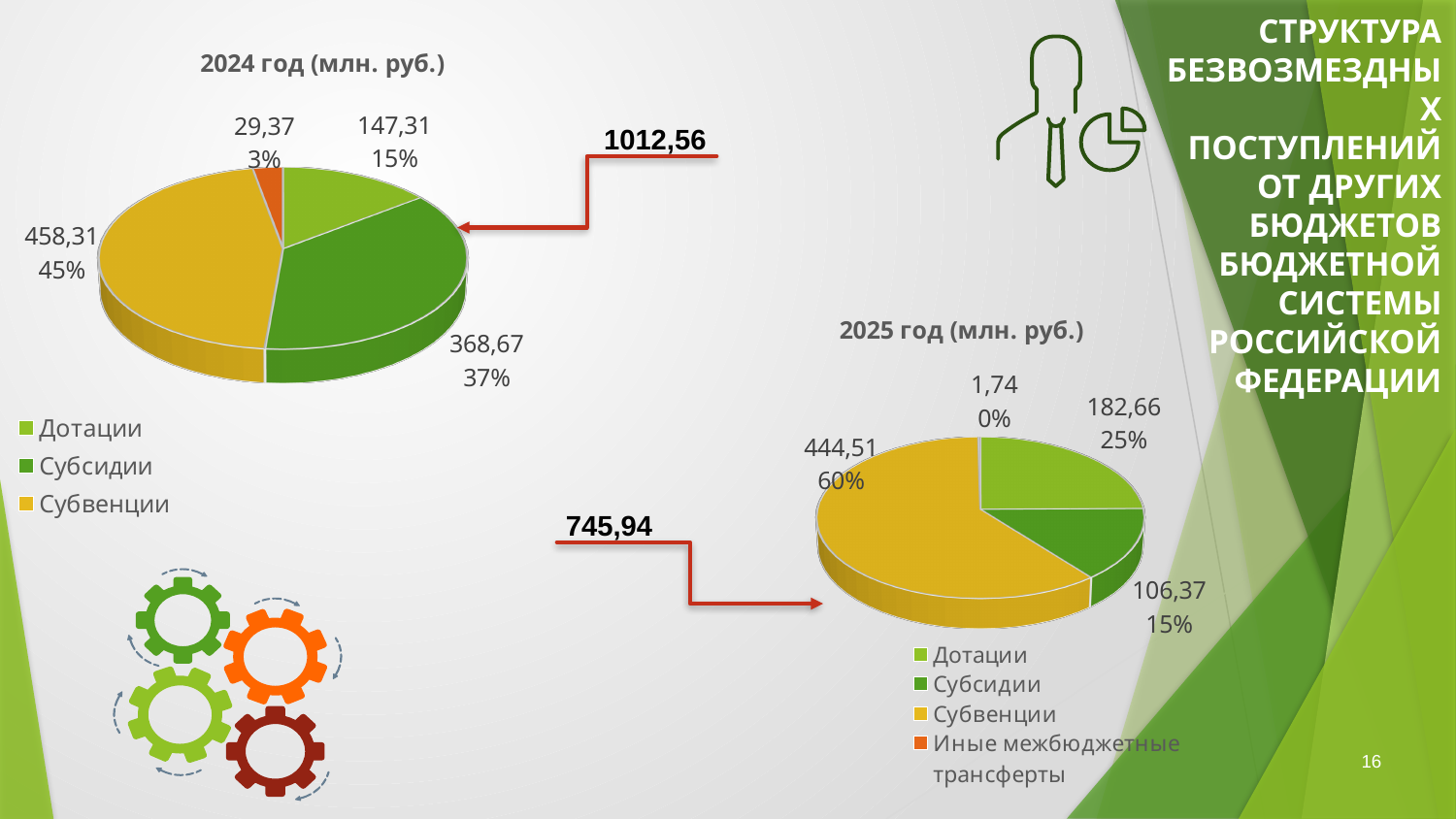
In the chart titled "2024 год (млн. руб.)", what share of the pie is Субсидии? 37% In the chart titled "2024 год (млн. руб.)", which category has the largest slice? Субвенции In the chart titled "2025 год (млн. руб.)", which is larger, Дотации or Субсидии? Дотации In the chart titled "2024 год (млн. руб.)", what is the value for Субвенции? 458,31 What kind of chart is the chart titled "2025 год (млн. руб.)"? Pie chart In the chart titled "2025 год (млн. руб.)", how many entries does the legend list? 4 In the chart titled "2025 год (млн. руб.)", what share of the pie is Дотации? 25% In the chart titled "2024 год (млн. руб.)", what is the difference between the values for Субвенции and Субсидии? 89,64 In the chart titled "2025 год (млн. руб.)", what is the difference between the values for Дотации and Субсидии? 76,29 In the chart titled "2024 год (млн. руб.)", what is the value for Дотации? 147,31 In the chart titled "2025 год (млн. руб.)", which category has the smallest slice? Иные межбюджетные трансферты In the chart titled "2025 год (млн. руб.)", what is the value for Субвенции? 444,51